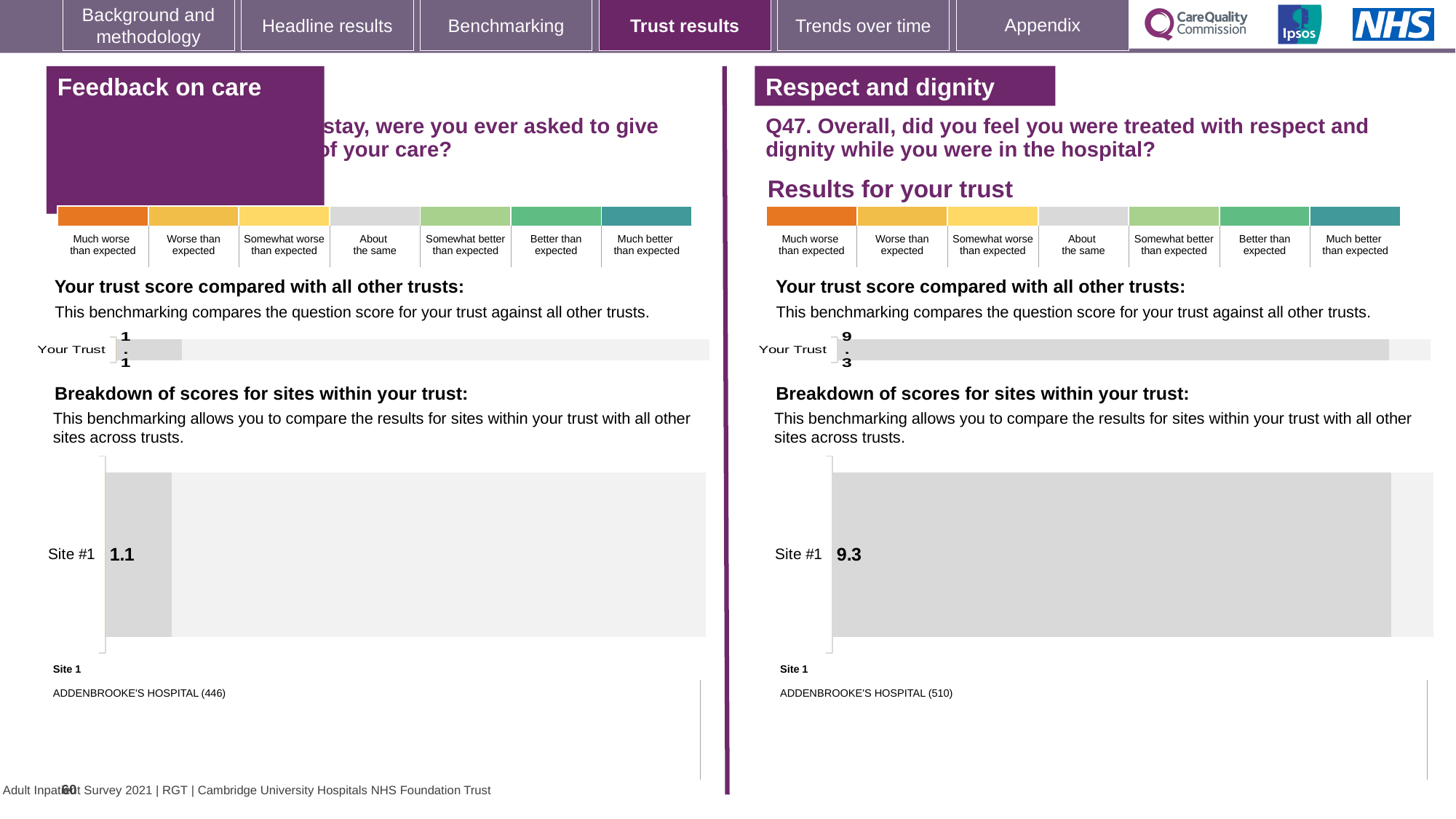
How many sites are plotted in the 'Feedback on care' breakdown of scores chart? 1 On the 'Feedback on care' section, what is the score shown for Site #1 in the breakdown of scores chart? 1.1 Which is larger: the Site #1 score in the 'Respect and dignity' breakdown chart or the Site #1 score in the 'Feedback on care' breakdown chart? Respect and dignity How many sites are plotted in the 'Respect and dignity' breakdown of scores chart? 1 What is the difference between the Your Trust score in the 'Respect and dignity' chart and the Your Trust score in the 'Feedback on care' chart? 8.2 On the 'Respect and dignity' section, what is the score shown for Site #1 in the breakdown of scores chart? 9.3 On the 'Feedback on care' section, what is the score shown for Your Trust in the trust score chart? 1.1 Which hospital is listed as Site 1 below the 'Feedback on care' breakdown chart? ADDENBROOKE'S HOSPITAL (446) What kind of chart is used to show the Site #1 score in the 'Feedback on care' breakdown section? bar chart On the 'Respect and dignity' section, what is the score shown for Your Trust in the trust score chart? 9.3 Which hospital is listed as Site 1 below the 'Respect and dignity' breakdown chart? ADDENBROOKE'S HOSPITAL (510) In the 'Respect and dignity' section, is the Your Trust score the same as the Site #1 score? Yes